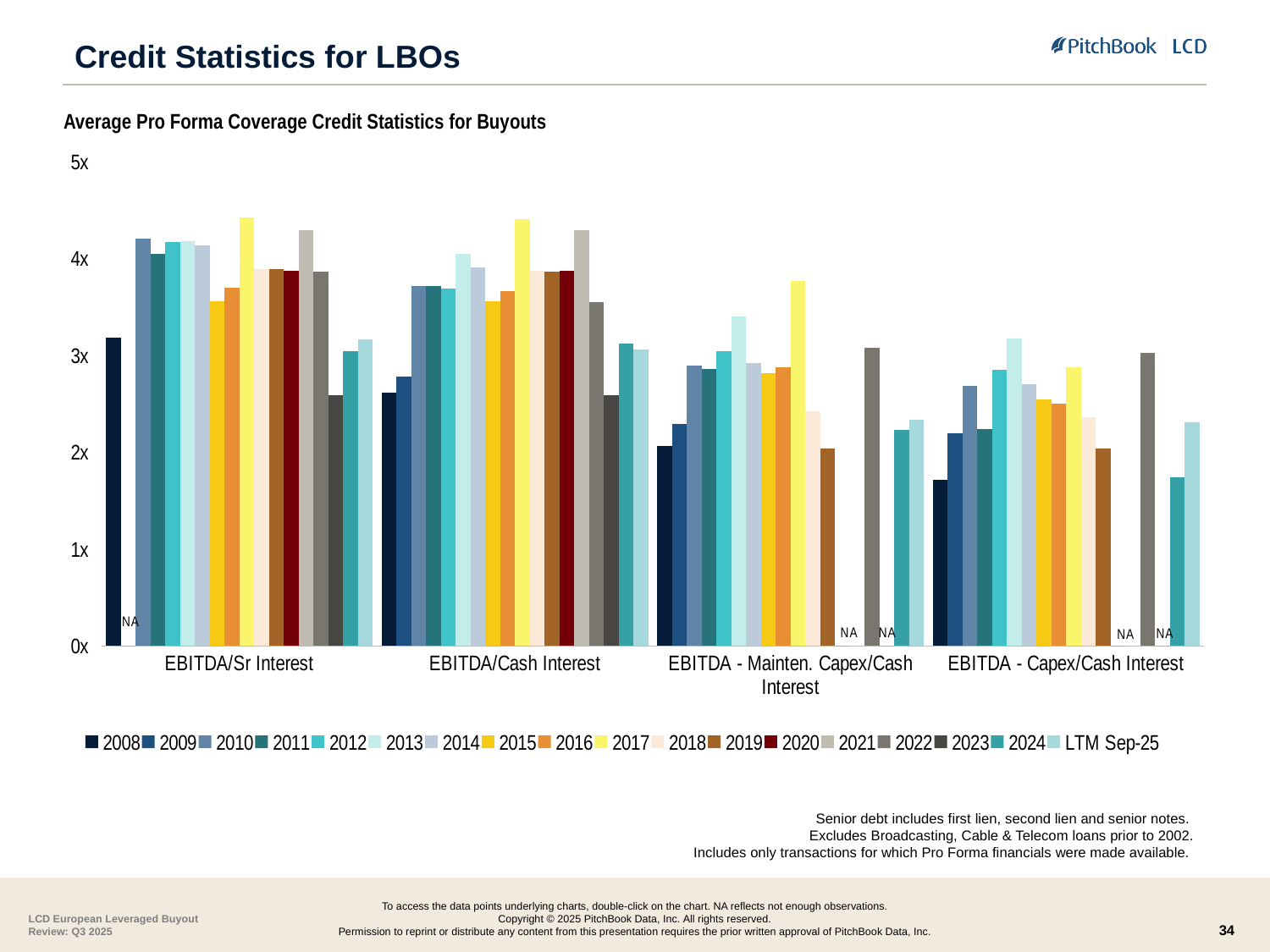
What kind of chart is shown on the slide? bar chart Is the value for 2008 in the EBITDA/Cash Interest category greater or less than 3x? less In the EBITDA/Cash Interest category, which is larger, the value for 2017 or the value for 2018? 2017 Is the value for 2008 in the EBITDA - Capex/Cash Interest category greater or less than 2x? less Is the value for 2017 in the EBITDA - Mainten. Capex/Cash Interest category greater or less than 3x? greater What is the title of the chart? Average Pro Forma Coverage Credit Statistics for Buyouts How many categories are shown on the x axis of the chart? 4 Which year has the lowest value in the EBITDA/Sr Interest category? 2023 How many series does the chart's legend list? 18 Which year has the highest value in the EBITDA - Mainten. Capex/Cash Interest category? 2017